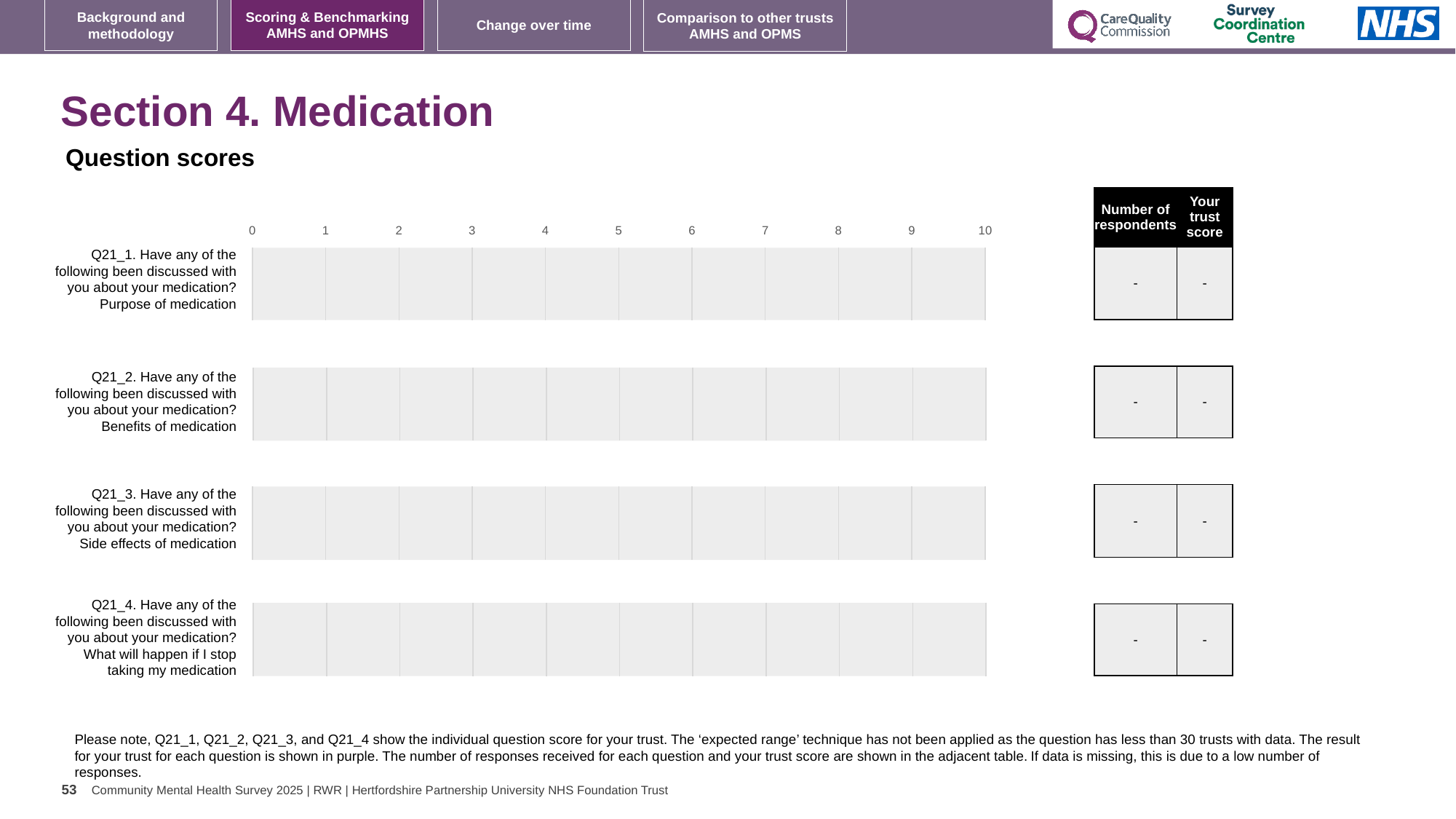
What is the 'Number of respondents' value shown for Q21_2 (Benefits of medication)? - What is the title of the section shown on the slide? Section 4. Medication What is the 'Your trust score' value shown for Q21_3 (Side effects of medication)? - What is the highest value shown on the chart's x axis? 10 What is the 'Number of respondents' value shown for Q21_4 (What will happen if I stop taking my medication)? - How many questions (categories) are listed on the chart? 4 What is the 'Your trust score' value shown for Q21_1 (Purpose of medication)? - What kind of chart is shown on the slide? bar chart